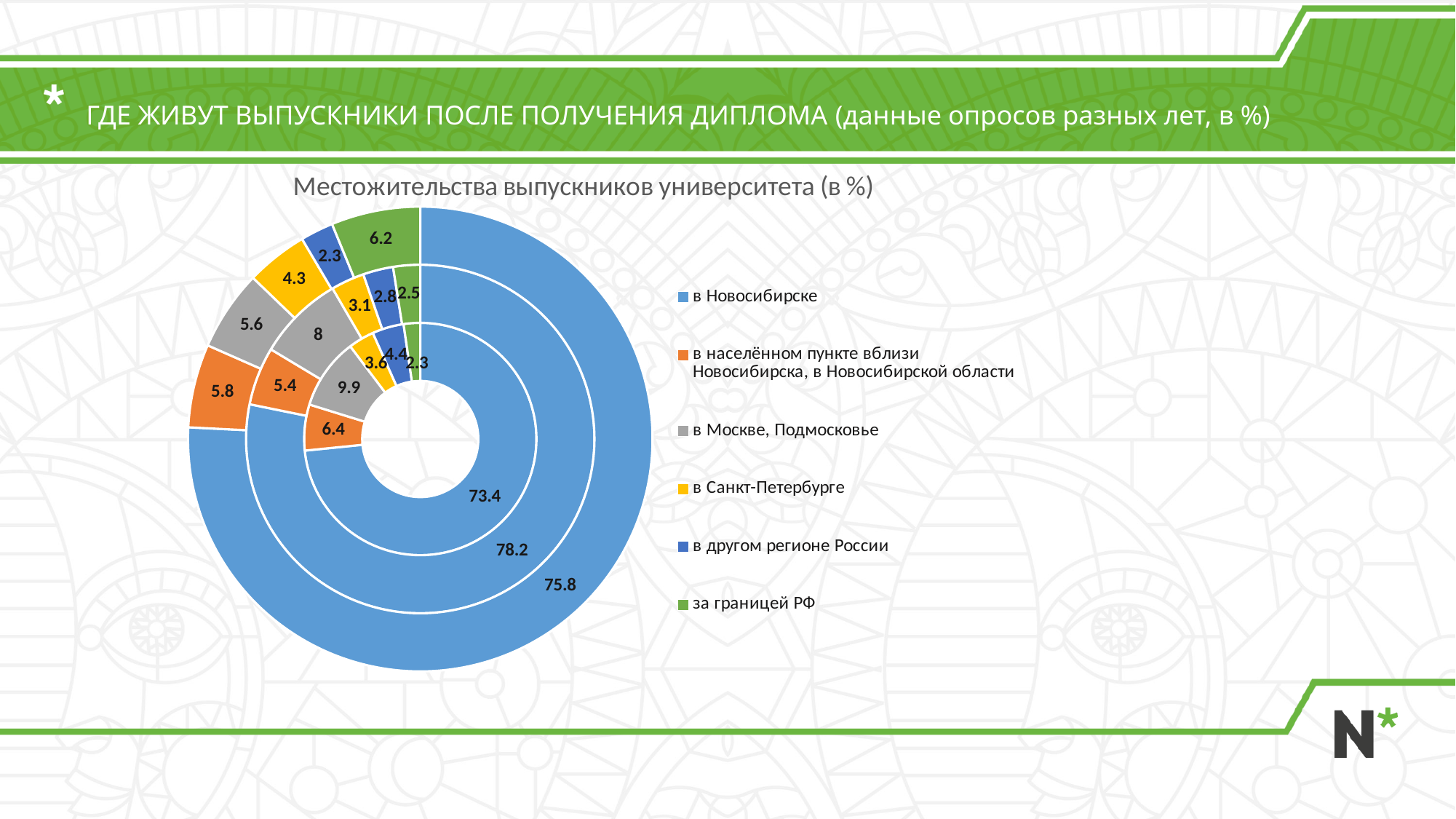
What is the value for 'в Новосибирске' in the innermost ring? 73.4 What is the value for 'за границей РФ' in the outer ring? 6.2 How many concentric rings does the doughnut chart have? 3 What kind of chart is shown on the slide? Doughnut chart What is the value for 'в Новосибирске' in the outer ring? 75.8 What is the title of the chart? Местожительства выпускников университета (в %) What is the value for 'в Москве, Подмосковье' in the innermost ring? 9.9 In the outer ring, which is larger: the value for 'в Санкт-Петербурге' or the value for 'за границей РФ'? за границей РФ What is the difference between the 'в Новосибирске' values in the middle ring (78.2) and the innermost ring (73.4)? 4.8 Which category has the largest value in the middle ring? в Новосибирске Which category has the smallest value in the outer ring? в другом регионе России How many entries does the chart legend list? 6